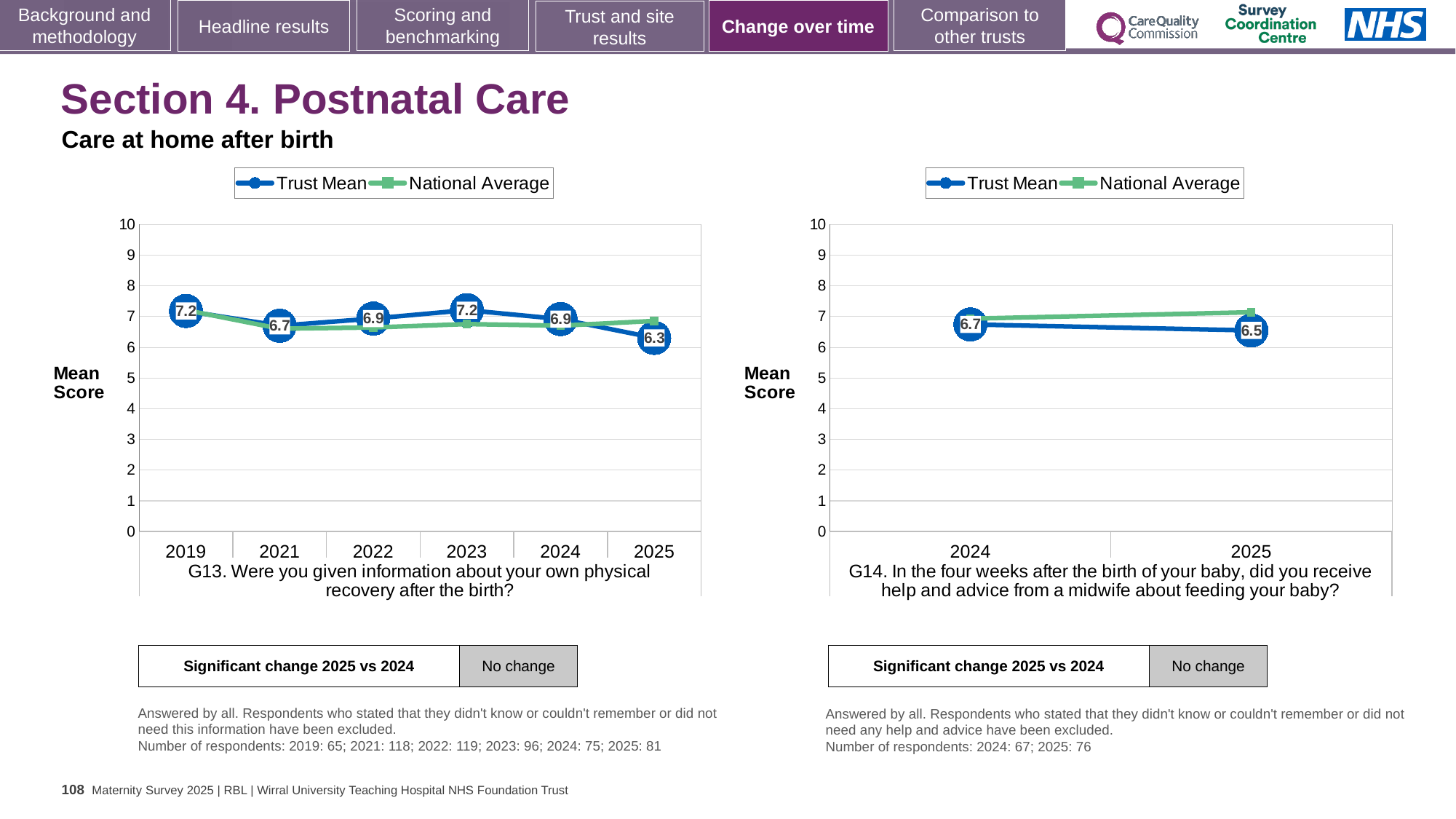
In the G14 chart on the right, does the Trust Mean rise or fall from 2024 to 2025? Fall In the G13 chart on the left, what is the Trust Mean score for 2025? 6.3 How many series does the legend of the G14 chart on the right list? 2 In the G13 chart on the left, what is the Trust Mean score for 2021? 6.7 In the G13 chart on the left, which year has the higher Trust Mean score, 2022 or 2025? 2022 In the G14 chart on the right, what is the Trust Mean score for 2024? 6.7 In the G14 chart on the right, is the National Average value for 2025 greater or less than 6? greater In the G14 chart on the right, what is the difference between the Trust Mean scores for 2024 and 2025? 0.2 In the G13 chart on the left, what is the difference between the Trust Mean scores for 2023 and 2025? 0.9 In the G13 chart on the left, which year has the lowest Trust Mean score? 2025 How many years are shown on the x axis of the G13 chart on the left? 6 What kind of chart is the G13 chart on the left? Line chart